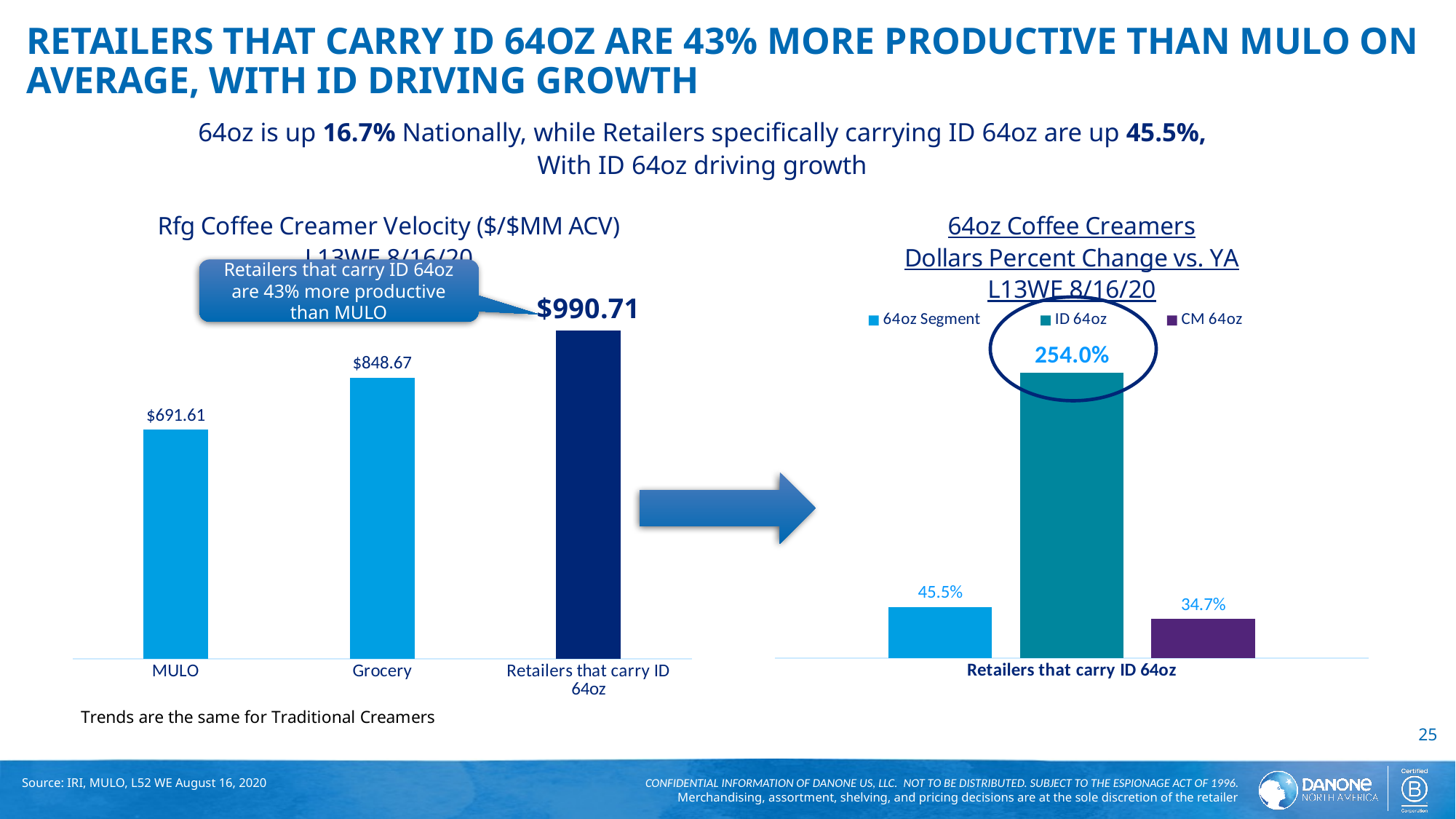
In the Rfg Coffee Creamer Velocity chart, which category has the lowest value? MULO In the Rfg Coffee Creamer Velocity chart, what is the value for Retailers that carry ID 64oz? $990.71 In the Rfg Coffee Creamer Velocity chart, what is the difference between Retailers that carry ID 64oz and MULO? $299.10 In the 64oz Coffee Creamers Dollars Percent Change chart, what is the value for CM 64oz? 34.7% In the 64oz Coffee Creamers Dollars Percent Change chart, how many series does the legend list? 3 In the Rfg Coffee Creamer Velocity chart, how many categories are shown? 3 In the 64oz Coffee Creamers Dollars Percent Change chart, which series has the lowest value? CM 64oz What kind of chart is the 64oz Coffee Creamers Dollars Percent Change chart? Bar chart In the Rfg Coffee Creamer Velocity chart, what is the value for MULO? $691.61 In the Rfg Coffee Creamer Velocity chart, which category has the highest value? Retailers that carry ID 64oz In the 64oz Coffee Creamers Dollars Percent Change chart, what is the value for ID 64oz? 254.0% In the Rfg Coffee Creamer Velocity chart, what is the value for Grocery? $848.67